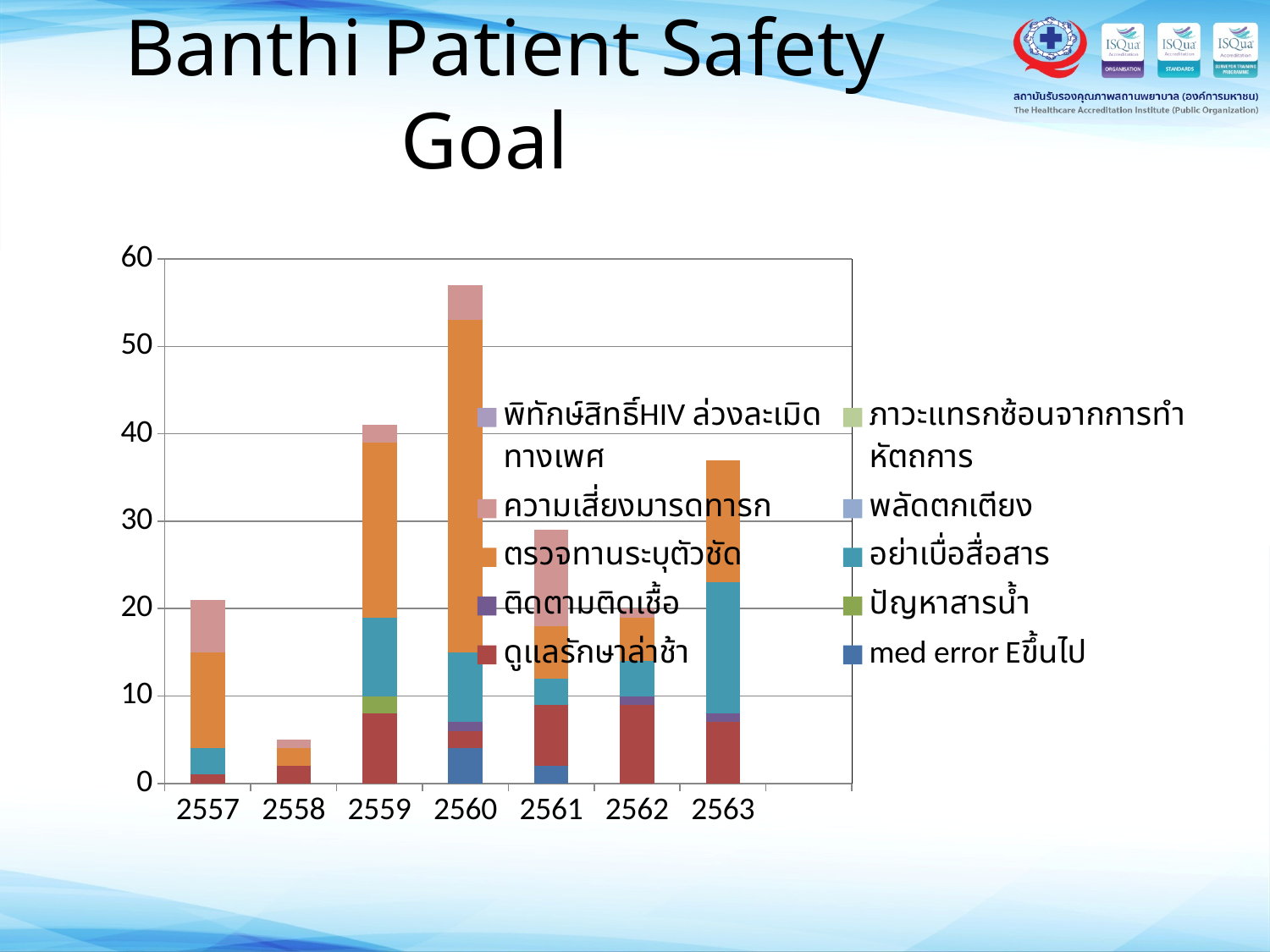
What kind of chart is shown on the slide? bar chart What is the title of the slide containing the chart? Banthi Patient Safety Goal Is the total of the stacked bar for 2558 greater or less than 10? less Is the total of the stacked bar for 2562 greater or less than 30? less How many years (categories) are shown on the x axis of the chart? 7 Which year has the tallest stacked bar in the chart? 2560 Is the total of the stacked bar for 2560 greater or less than 50? greater Which stacked bar is taller, 2559 or 2561? 2559 Which year has the shortest stacked bar in the chart? 2558 How many series does the chart's legend list? 10 Which stacked bar is taller, 2562 or 2563? 2563